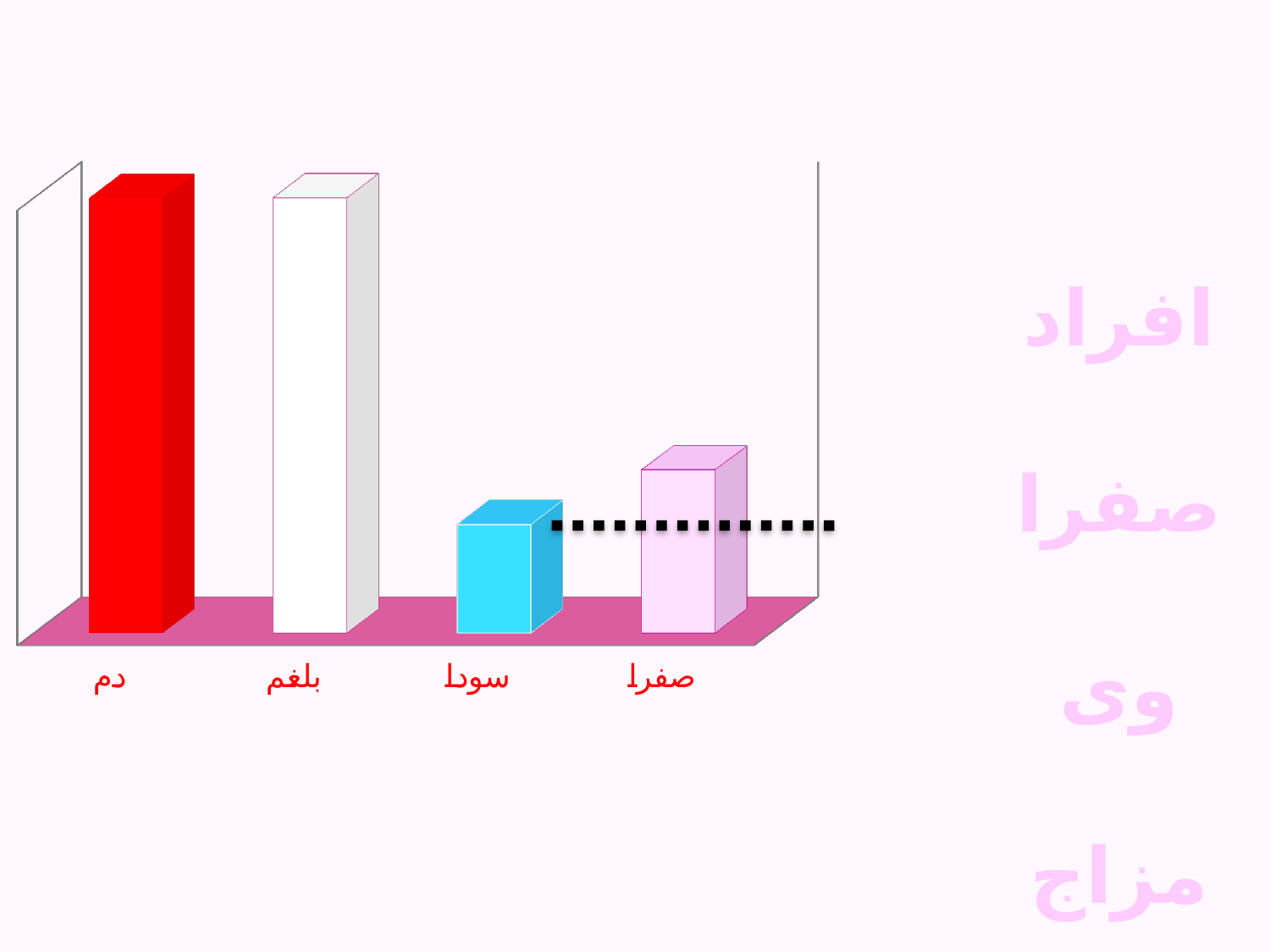
Which bar is taller, دم or سودا? دم What colour is the bar for دم? red What colour is the bar for سودا? blue Which category has the lowest bar in the chart? سودا Which bar is taller, بلغم or صفرا? بلغم What kind of chart is shown on the slide? bar chart How many categories are shown on the x axis of the chart? 4 Which bar is shorter, دم or صفرا? صفرا